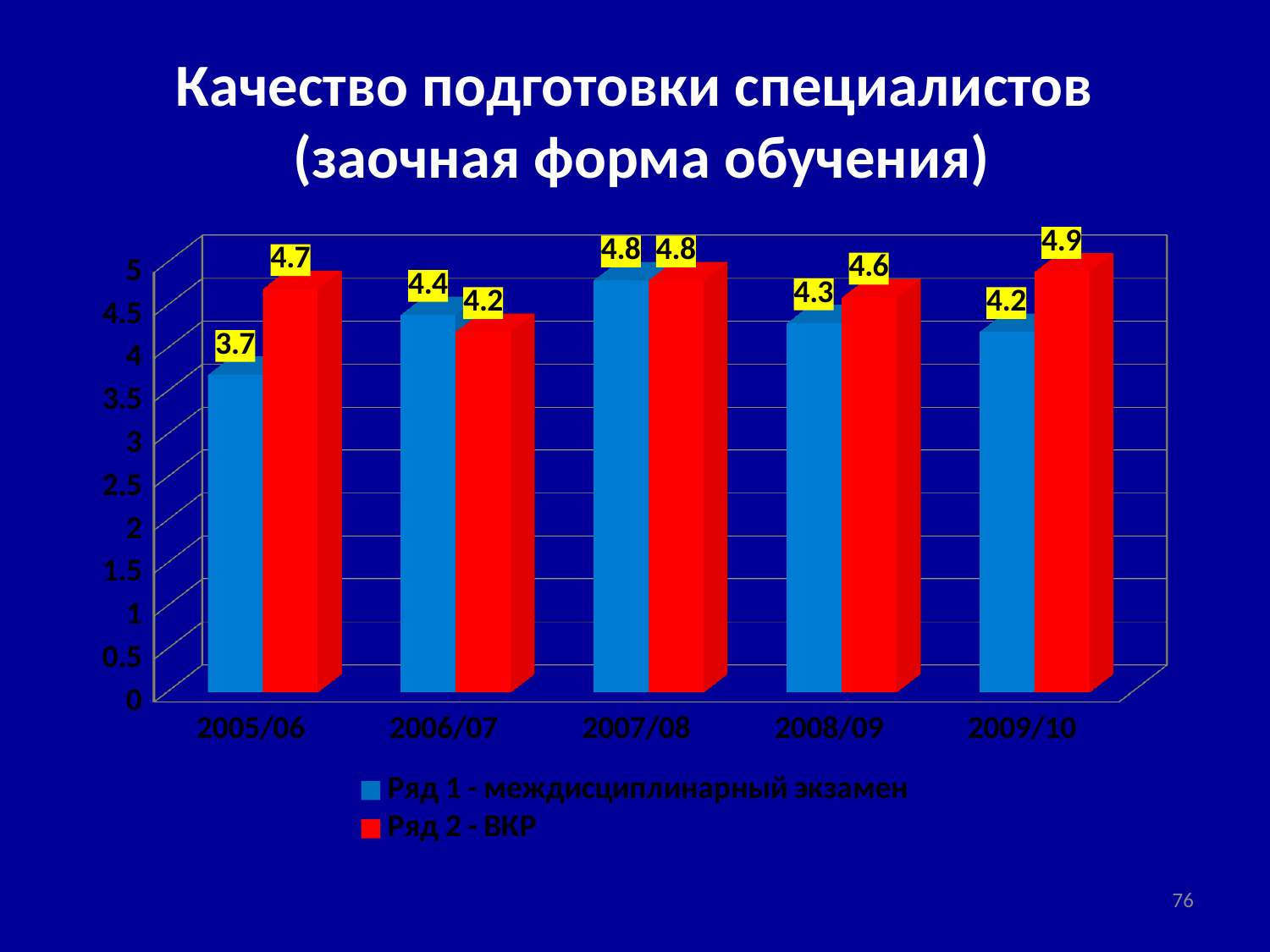
What is the value of Ряд 1 - междисциплинарный экзамен for 2005/06? 3.7 What colour are the bars for Ряд 2 - ВКР? red What is the value of Ряд 2 - ВКР for 2009/10? 4.9 What type of chart is shown on the slide? bar chart What is the value of Ряд 2 - ВКР for 2006/07? 4.2 How many academic years are shown on the x axis? 5 In which year is Ряд 1 - междисциплинарный экзамен lowest? 2005/06 In which year is Ряд 1 - междисциплинарный экзамен highest? 2007/08 In which year is Ряд 2 - ВКР lowest? 2006/07 Which series has the larger value in 2006/07, Ряд 1 - междисциплинарный экзамен or Ряд 2 - ВКР? Ряд 1 - междисциплинарный экзамен How many series does the legend list? 2 What is the difference between Ряд 2 - ВКР and Ряд 1 - междисциплинарный экзамен in 2005/06? 1